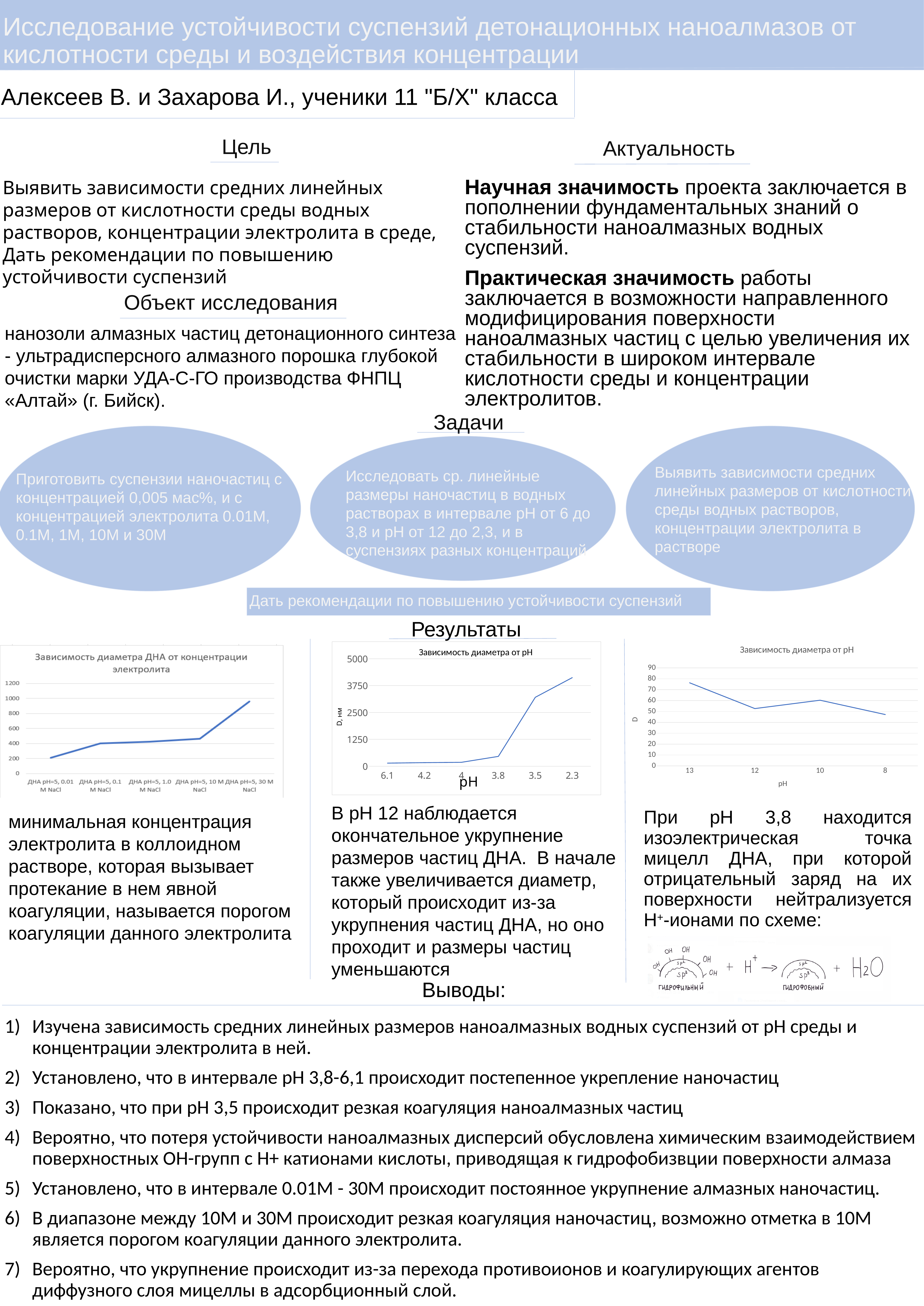
On the left chart, which category has the lowest value? ДНА pH=5, 0.01 M NaCl What kind of chart is the left chart titled 'Зависимость диаметра ДНА от концентрации электролита'? line chart On the middle chart, what is the label of the y axis? D, нм How many data points are plotted on the left chart titled 'Зависимость диаметра ДНА от концентрации электролита'? 5 On the left chart, is the value for ДНА pH=5, 30 M NaCl greater or less than 800? greater On the middle chart, at which pH value is the diameter highest? 2.3 On the middle chart, how many pH values are plotted along the x axis? 6 On the left chart, is the value for ДНА pH=5, 0.01 M NaCl greater or less than 400? less On the middle chart, is the value at pH 3.5 greater or less than 2500? greater On the right chart, which pH value has the highest diameter? 13 On the left chart, which category has the highest value? ДНА pH=5, 30 M NaCl